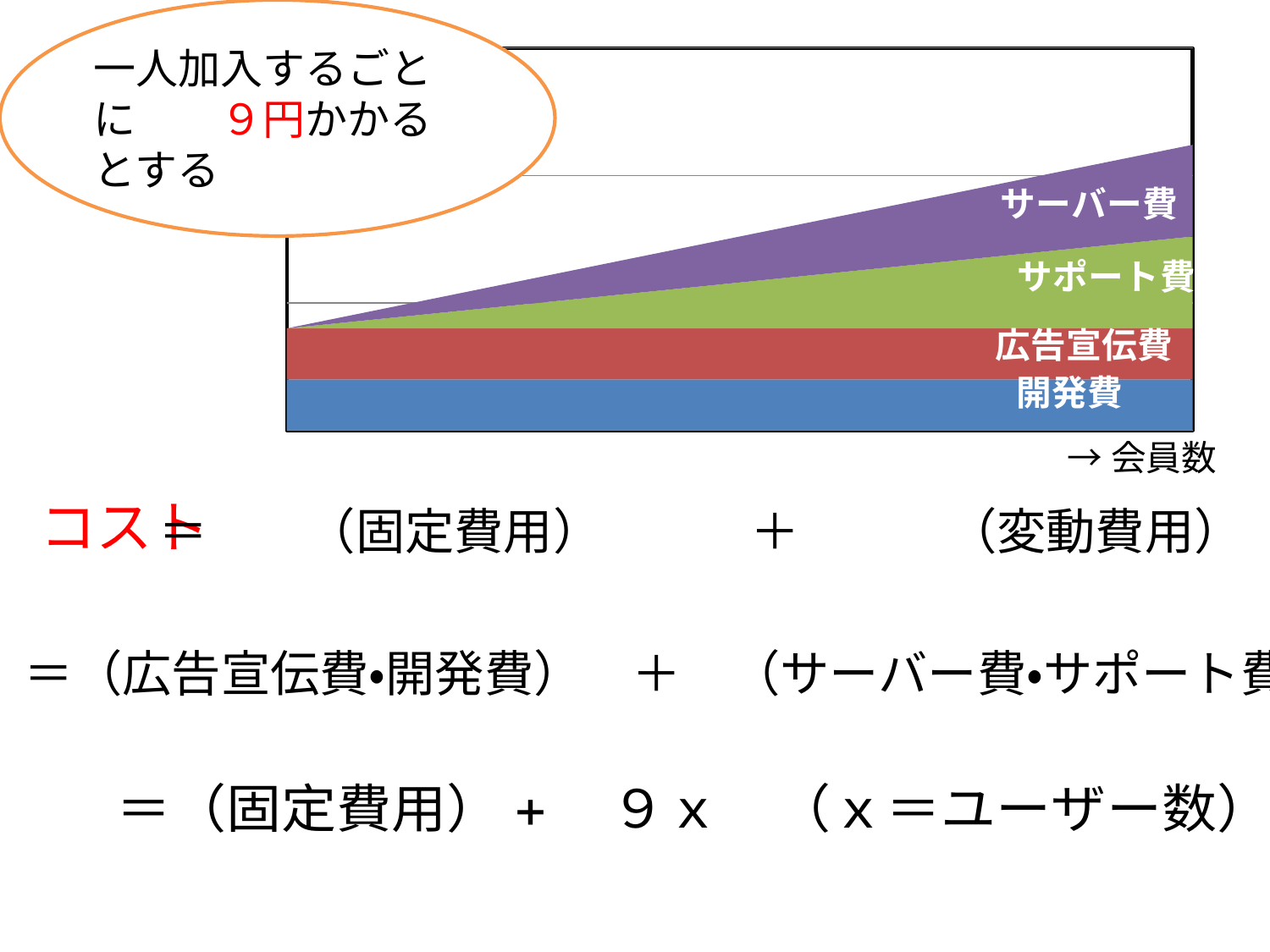
Does the サーバー費 layer grow, shrink, or stay constant as 会員数 increases along the x axis? grows Does the total stacked cost rise or fall as 会員数 increases along the x axis? rises Which cost category is the bottom layer of the stacked chart? 開発費 What does the x axis of the chart represent, according to the label below it? 会員数 How many cost categories are plotted as layers in the chart? 4 Does the 開発費 layer grow, shrink, or stay constant as 会員数 increases along the x axis? stays constant What kind of chart is shown on the slide? stacked area chart